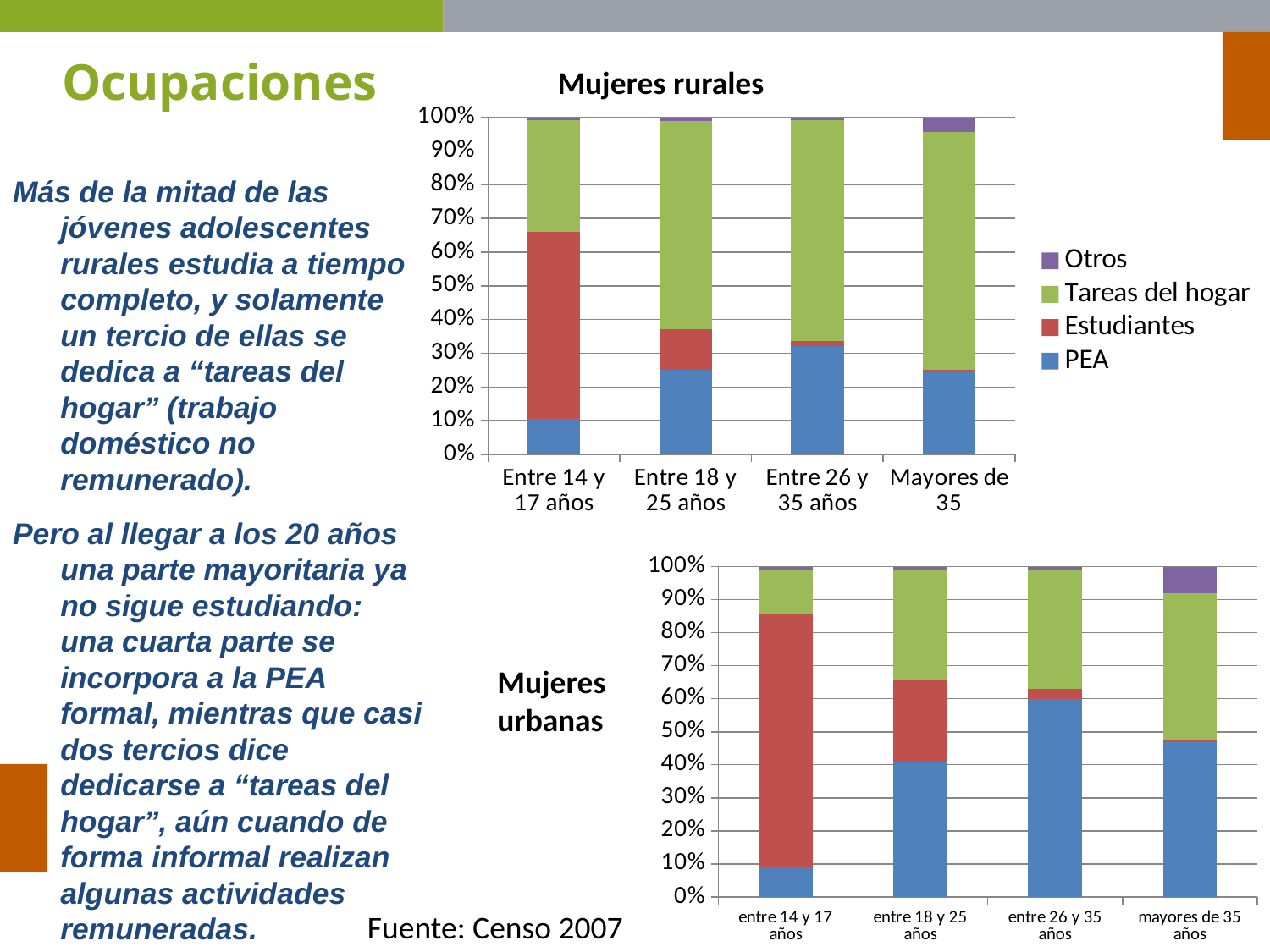
In the 'Mujeres rurales' chart, is the PEA share for 'Entre 26 y 35 años' greater or less than 20%? greater How many age categories are shown on the x axis of the 'Mujeres rurales' chart? 4 How many series does the legend of the 'Mujeres rurales' chart list? 4 In the 'Mujeres urbanas' chart, does the Estudiantes share rise or fall as age increases along the x axis? fall What kind of chart is the 'Mujeres rurales' chart? stacked bar chart In the 'Mujeres rurales' chart, which age group has the smallest PEA share? Entre 14 y 17 años In the 'Mujeres rurales' chart, which age group has the larger Estudiantes share, 'Entre 14 y 17 años' or 'Entre 18 y 25 años'? Entre 14 y 17 años In the 'Mujeres urbanas' chart, is the PEA share for 'entre 26 y 35 años' greater or less than 50%? greater In the 'Mujeres urbanas' chart, is the PEA share for 'entre 18 y 25 años' greater or less than 30%? greater In the 'Mujeres rurales' chart, which age group has the largest PEA share? Entre 26 y 35 años In the 'Mujeres urbanas' chart, which age group has the largest PEA share? entre 26 y 35 años What colour represents 'Tareas del hogar' in the legend of the 'Mujeres rurales' chart? green